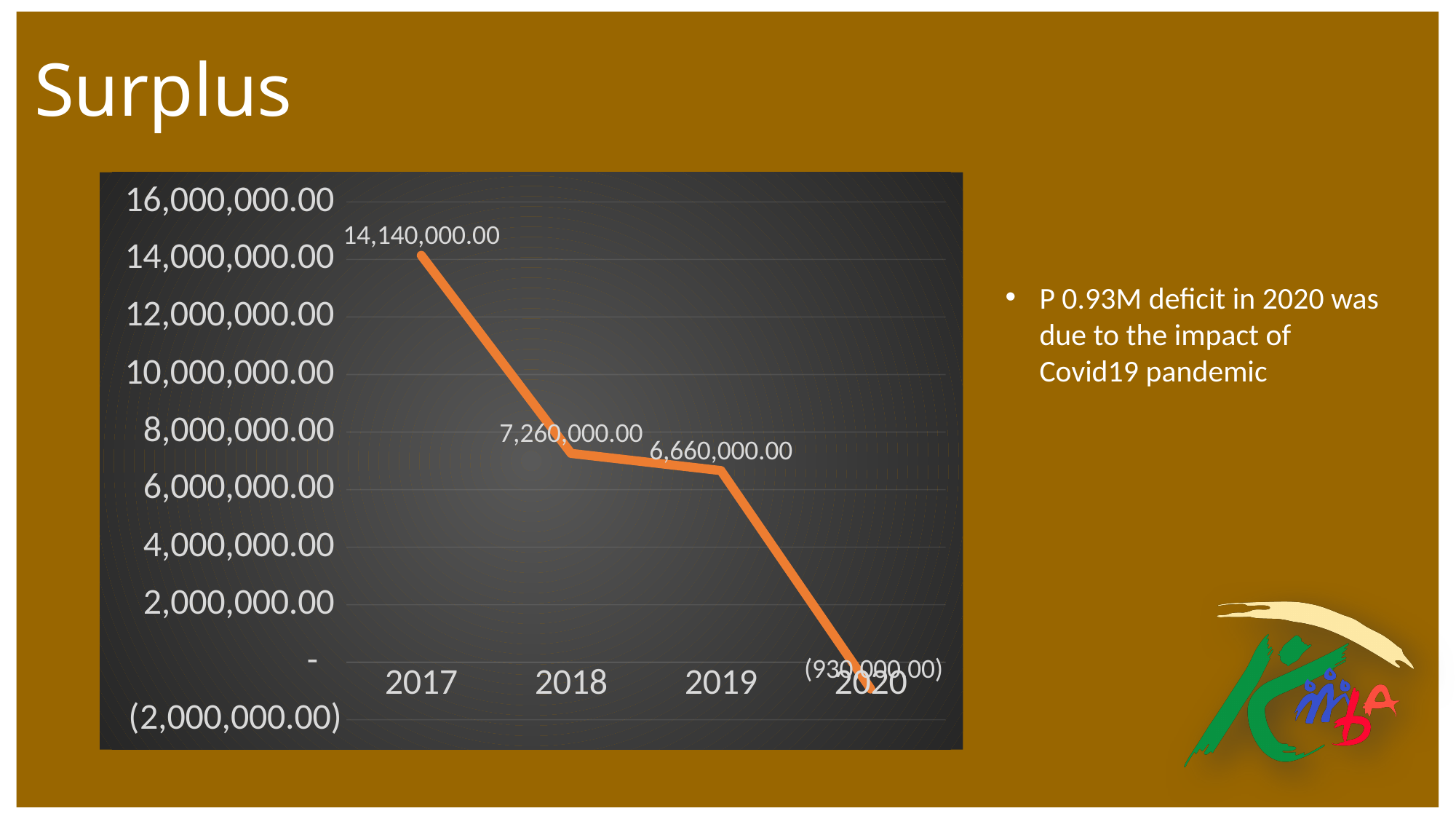
Which is larger, the value for 2018 or the value for 2019? 2018 What kind of chart is shown on the slide? line chart What is the difference between the 2018 and 2019 values? 600,000.00 Do the values rise or fall from 2017 to 2020? fall What is the surplus value for 2017? 14,140,000.00 What is the difference between the 2017 and 2018 values? 6,880,000.00 How many years are plotted on the chart? 4 Which year has the highest surplus? 2017 What is the value shown for 2020? (930,000.00) What is the surplus value for 2019? 6,660,000.00 What is the surplus value for 2018? 7,260,000.00 Which year has the lowest value? 2020